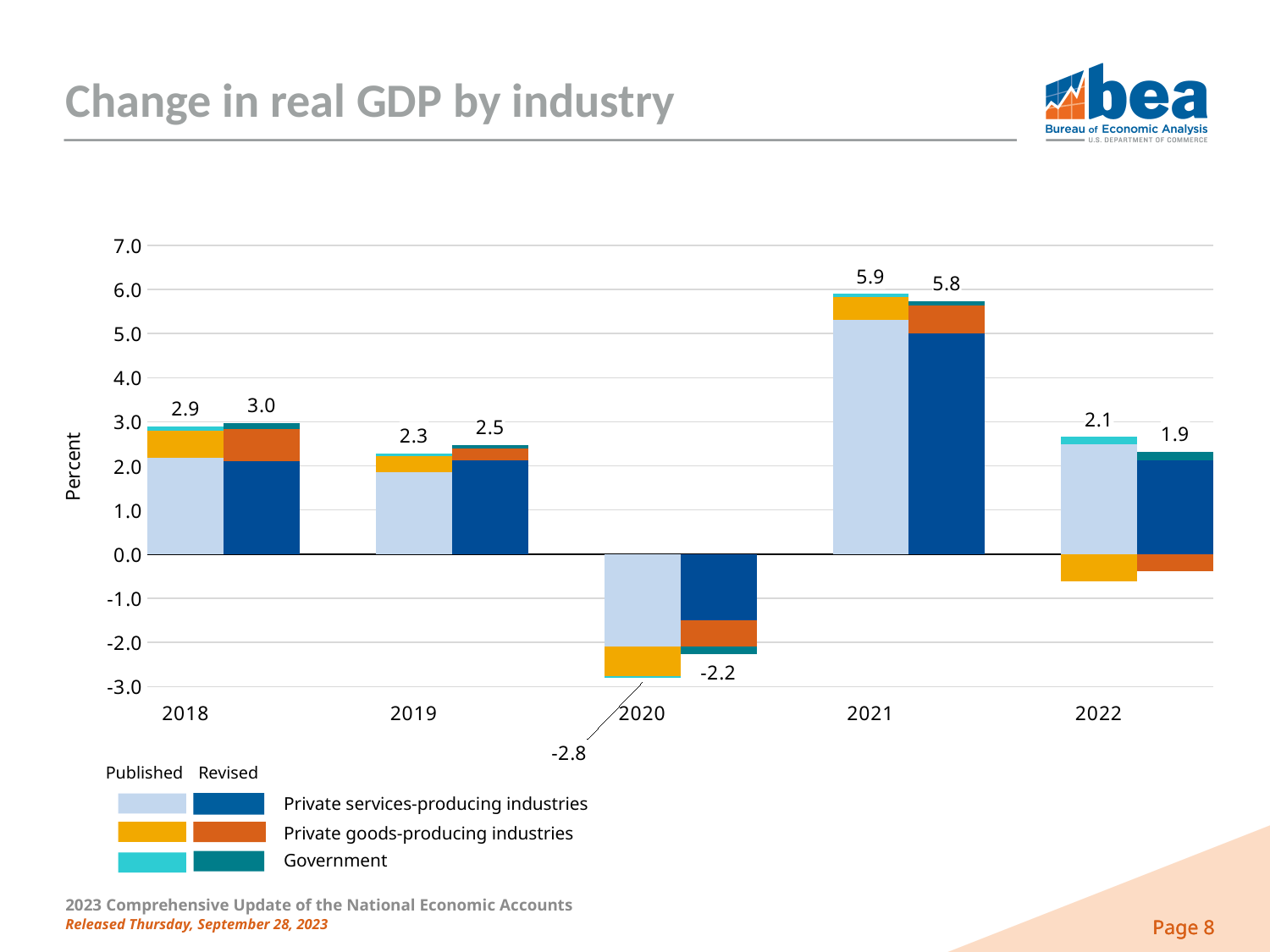
How many years are shown on the x axis? 5 Which year has the lowest revised total? 2020 Is the published value for private services-producing industries in 2021 greater or less than 5.0? greater What is the label on the y axis? Percent Do the published totals rise or fall from 2021 to 2022? Fall What is the difference between the published total (5.9) and the revised total (5.8) for 2021? 0.1 What kind of chart is shown on the slide? Stacked bar chart What is the revised total change in real GDP for 2020? -2.2 What is the published total for 2020? -2.8 What is the published total change in real GDP for 2021? 5.9 For 2019, which is larger: the published total or the revised total? Revised (2.5) Which year has the highest published total? 2021